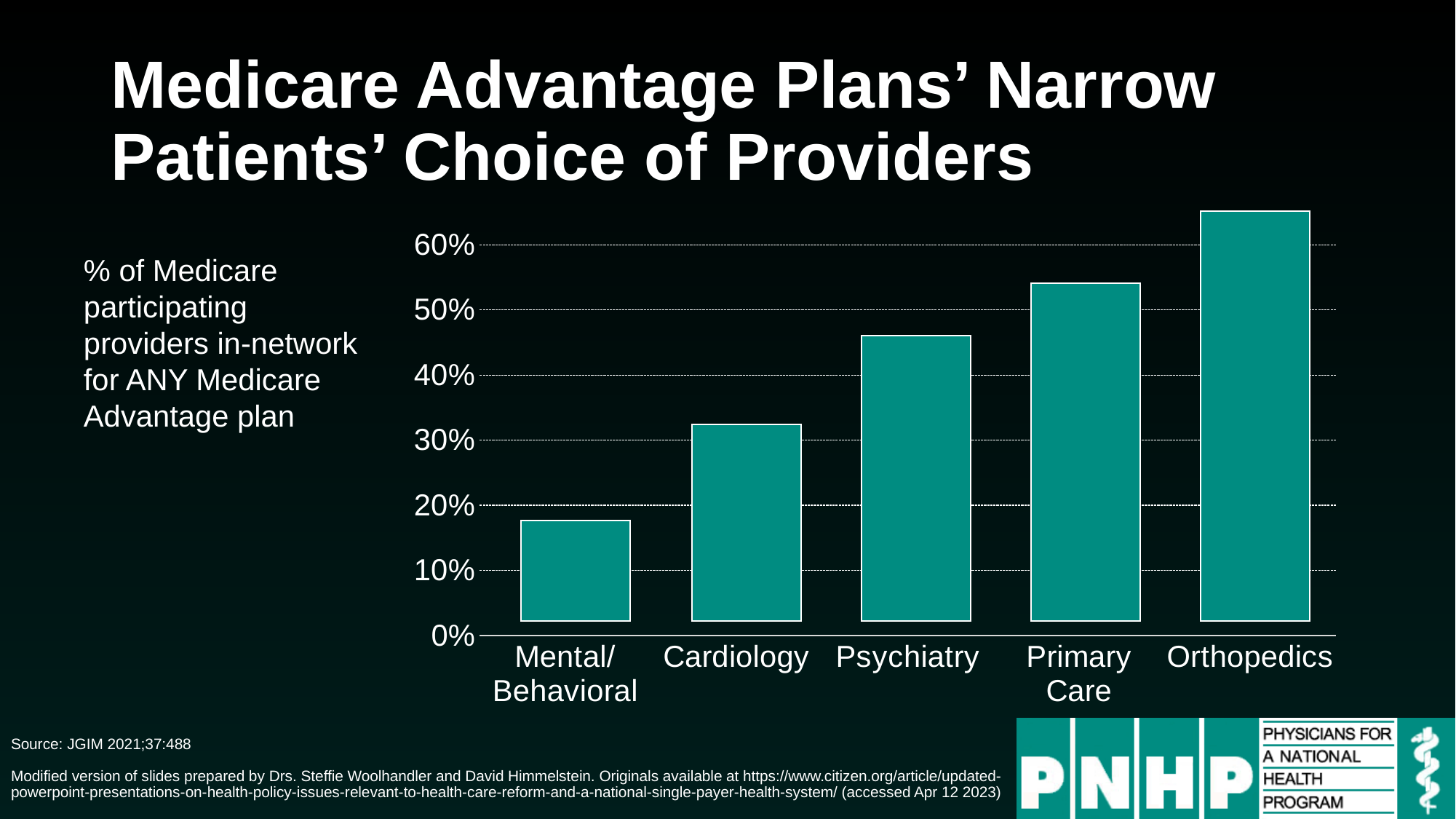
Is the value for Orthopedics greater or less than 60%? greater What kind of chart is shown on the slide? bar chart Do the bar values rise or fall moving from left to right along the x axis? rise How many specialty categories are shown on the x axis of the chart? 5 Is the value for Cardiology greater or less than 30%? greater Which category has the lowest percentage of Medicare participating providers in-network for any Medicare Advantage plan? Mental/Behavioral Is the value for Psychiatry greater or less than 40%? greater Which is larger, the value for Cardiology or the value for Psychiatry? Psychiatry Which category has the highest percentage of Medicare participating providers in-network for any Medicare Advantage plan? Orthopedics What is the title of the slide containing the chart? Medicare Advantage Plans' Narrow Patients' Choice of Providers